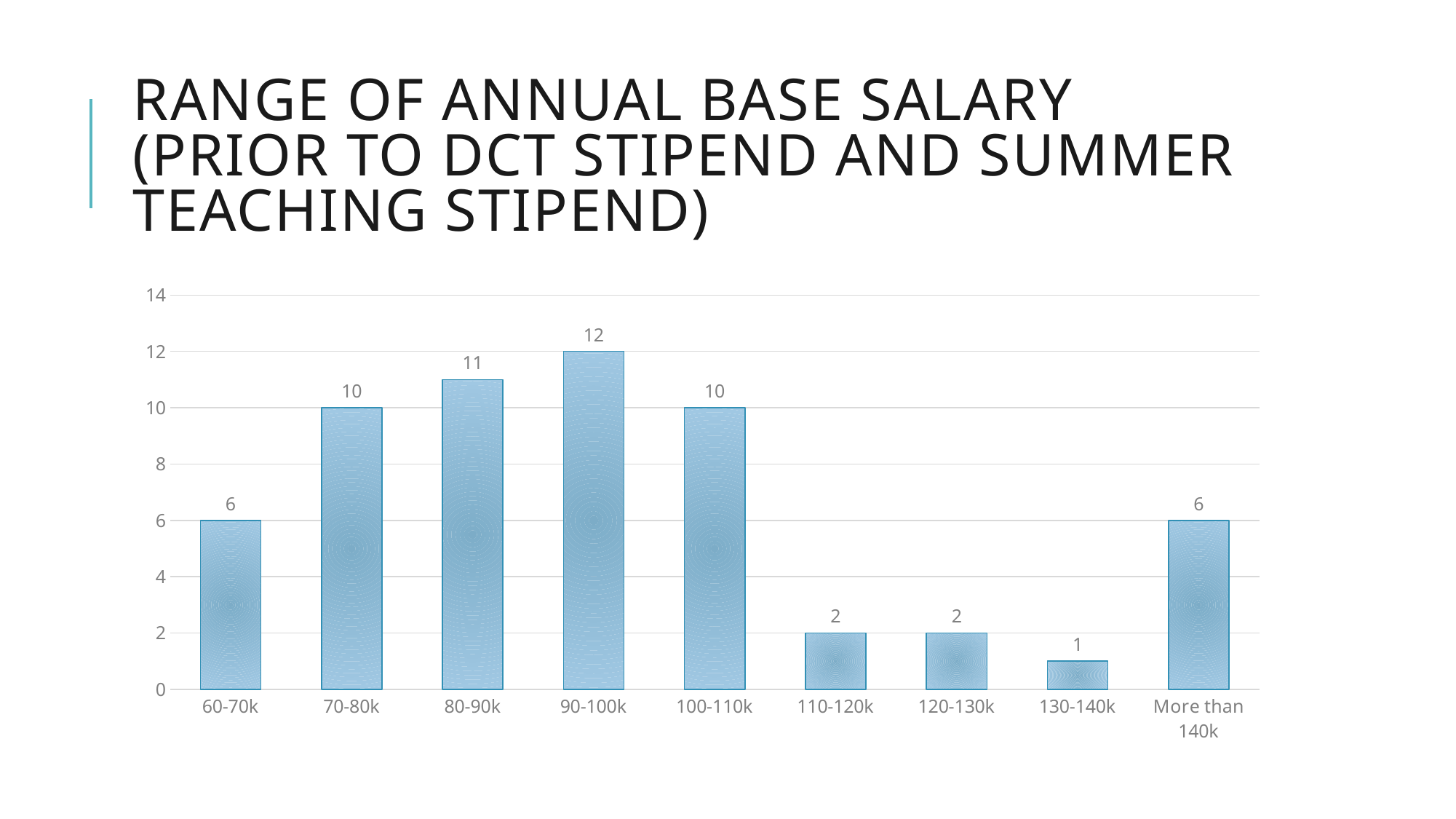
What is the title of the slide? Range of Annual Base Salary (Prior to DCT Stipend and Summer Teaching Stipend) What kind of chart is shown on the slide? Bar chart What is the value for the 60-70k salary range? 6 What is the difference between the values for 80-90k and 110-120k? 9 What is the value for the 130-140k salary range? 1 What is the value for the 90-100k salary range? 12 Which is larger, the value for 70-80k or the value for 60-70k? 70-80k How many salary range categories are shown on the x axis? 9 Which salary range has the lowest value? 130-140k Which salary range has the highest value? 90-100k Is the value for 100-110k greater or less than 8? greater What is the value for the 'More than 140k' category? 6